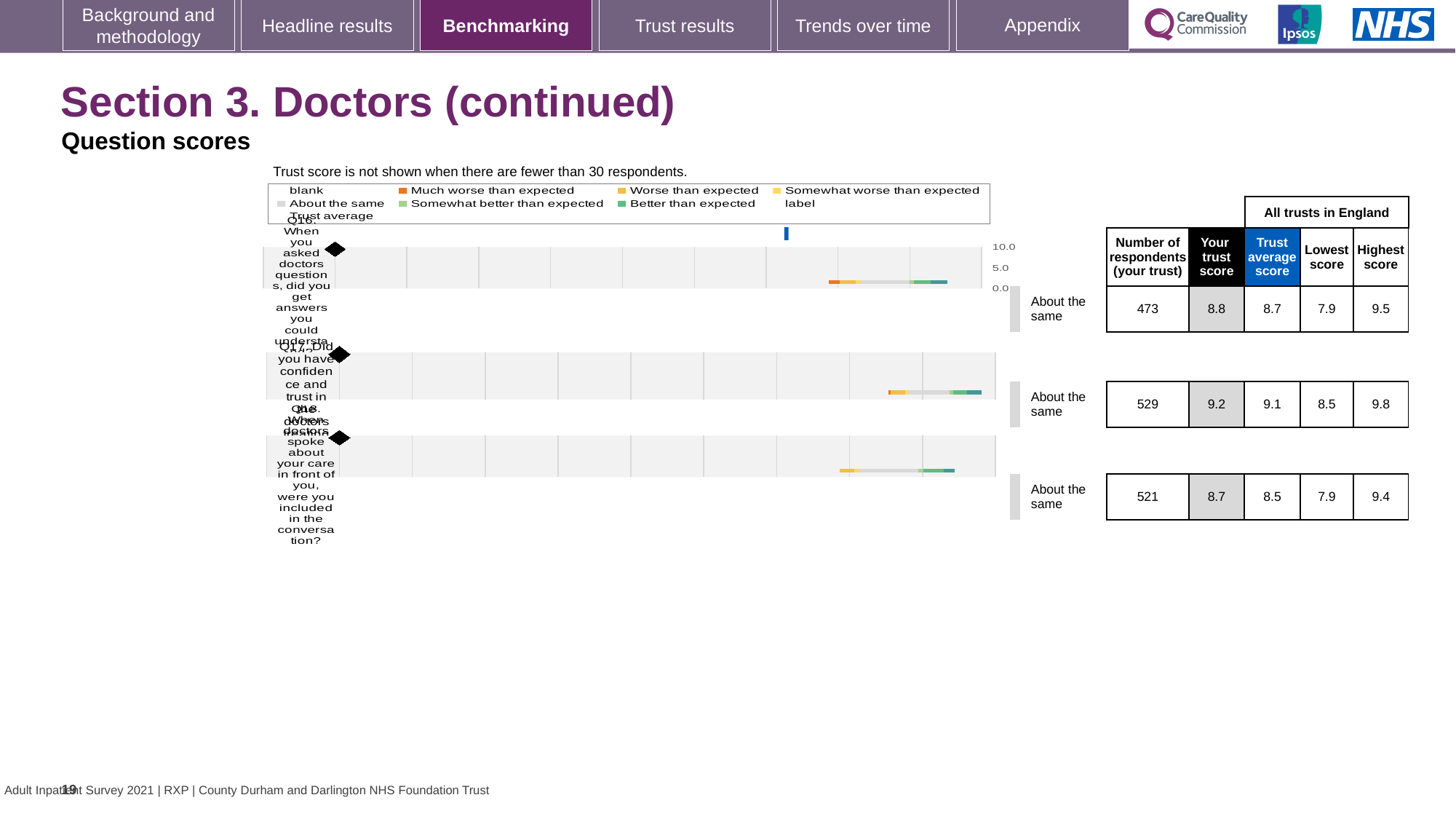
What is the 'Your trust score' for Q16 (When you asked doctors questions, did you get answers you could understand)? 8.8 How many questions are plotted on the chart? 3 What benchmark category label is shown next to each of the three questions? About the same How many respondents (your trust) are shown for Q17 (Did you have confidence and trust in the doctors treating you)? 529 What kind of chart is used to show the question scores? Bar chart What is the highest score across all trusts in England for Q17? 9.8 What is the difference between the highest and lowest scores across all trusts in England for Q17? 1.3 What is the lowest score across all trusts in England for Q16? 7.9 What is the difference between 'Your trust score' and the trust average score for Q16? 0.1 What is the trust average score for Q18 (When doctors spoke about your care in front of you, were you included in the conversation)? 8.5 Which question has the highest 'Your trust score'? Q17 For Q18, which is larger: 'Your trust score' or the trust average score? Your trust score